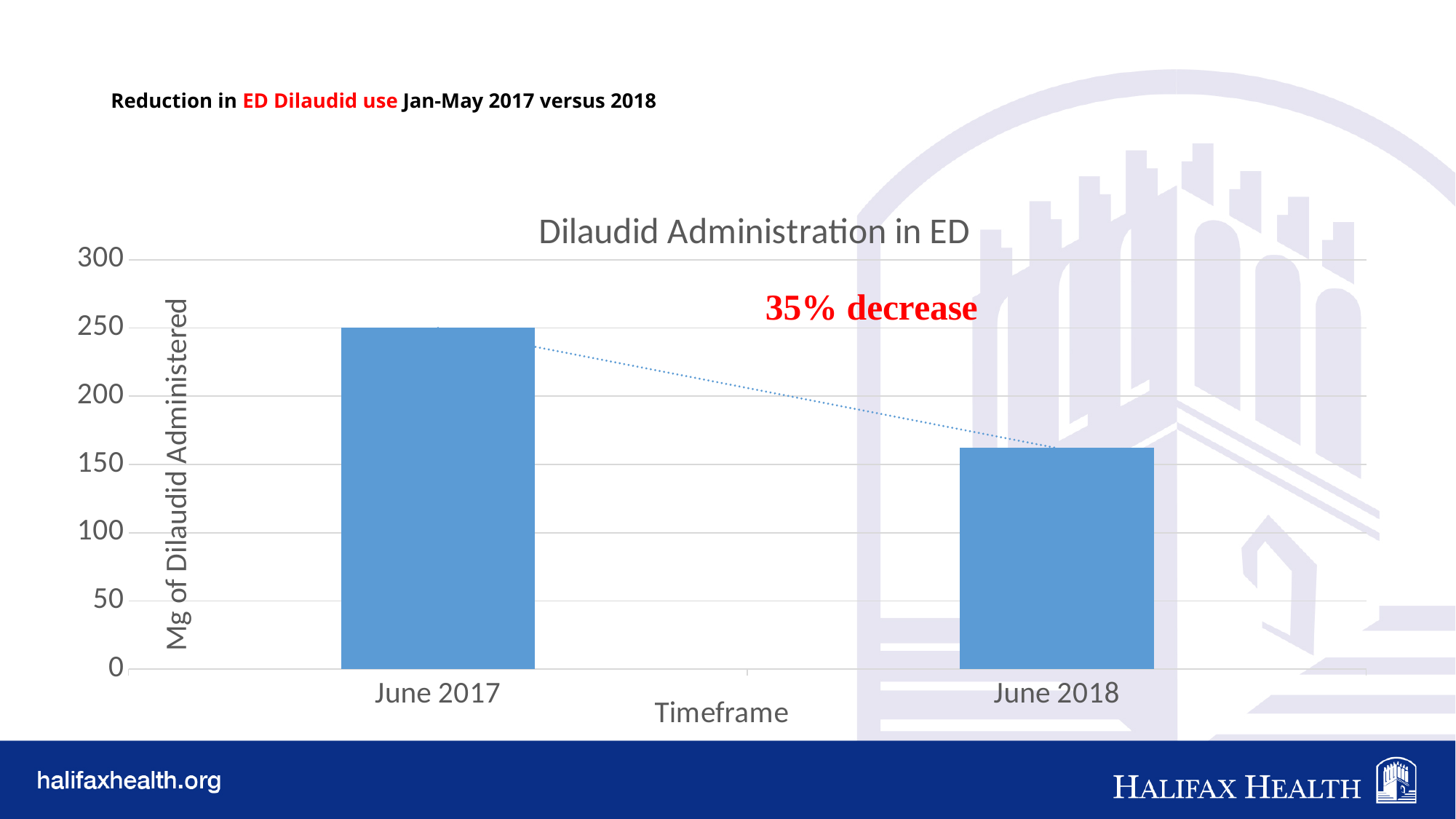
What is the value for June 2017 in the Dilaudid Administration in ED chart? 250 Do the values rise or fall from June 2017 to June 2018? fall Is the value for June 2018 greater or less than 150? greater Which is larger, the value for June 2017 or the value for June 2018? June 2017 What kind of chart is shown on the slide? bar chart Which timeframe has the highest value in the chart? June 2017 What is the title of the chart? Dilaudid Administration in ED How many categories are plotted on the x axis of the chart? 2 Which timeframe has the lowest value in the chart? June 2018 What is the label of the vertical axis of the chart? Mg of Dilaudid Administered Is the value for June 2018 greater or less than 200? less